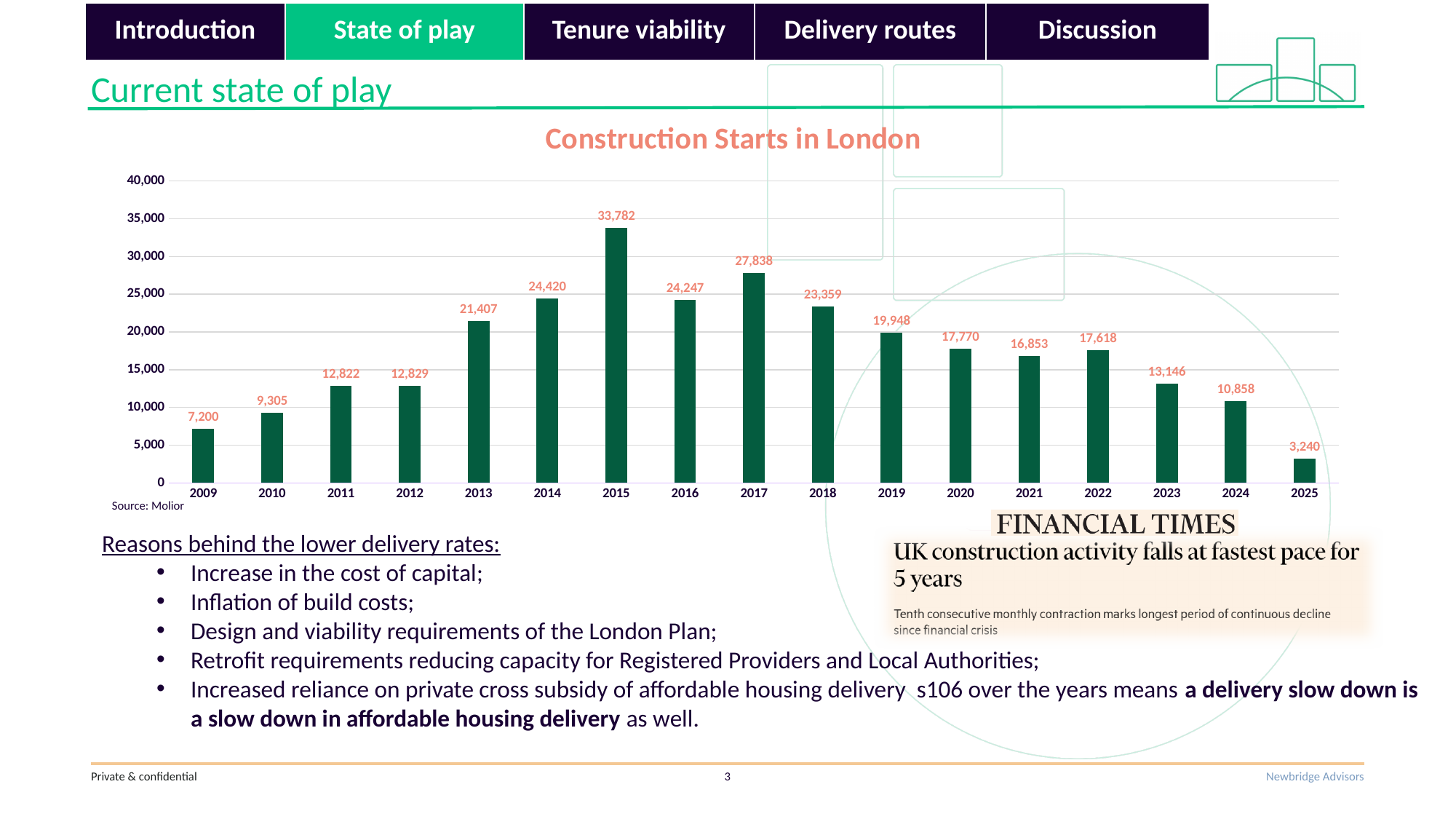
What is the value for 2015 in the Construction Starts in London chart? 33,782 Is the value for 2019 in the Construction Starts in London chart greater or less than 15,000? greater How many years are shown on the x axis of the Construction Starts in London chart? 17 What source is cited below the Construction Starts in London chart? Molior What is the difference between the values for 2017 and 2018 in the Construction Starts in London chart? 4,479 Which year has the highest value in the Construction Starts in London chart? 2015 What is the value for 2009 in the Construction Starts in London chart? 7,200 What kind of chart is the Construction Starts in London chart? bar chart Which year has the lowest value in the Construction Starts in London chart? 2025 What is the value for 2025 in the Construction Starts in London chart? 3,240 Which is larger in the Construction Starts in London chart, the value for 2014 or the value for 2016? 2014 Do the values in the Construction Starts in London chart rise or fall from 2015 to 2025? fall